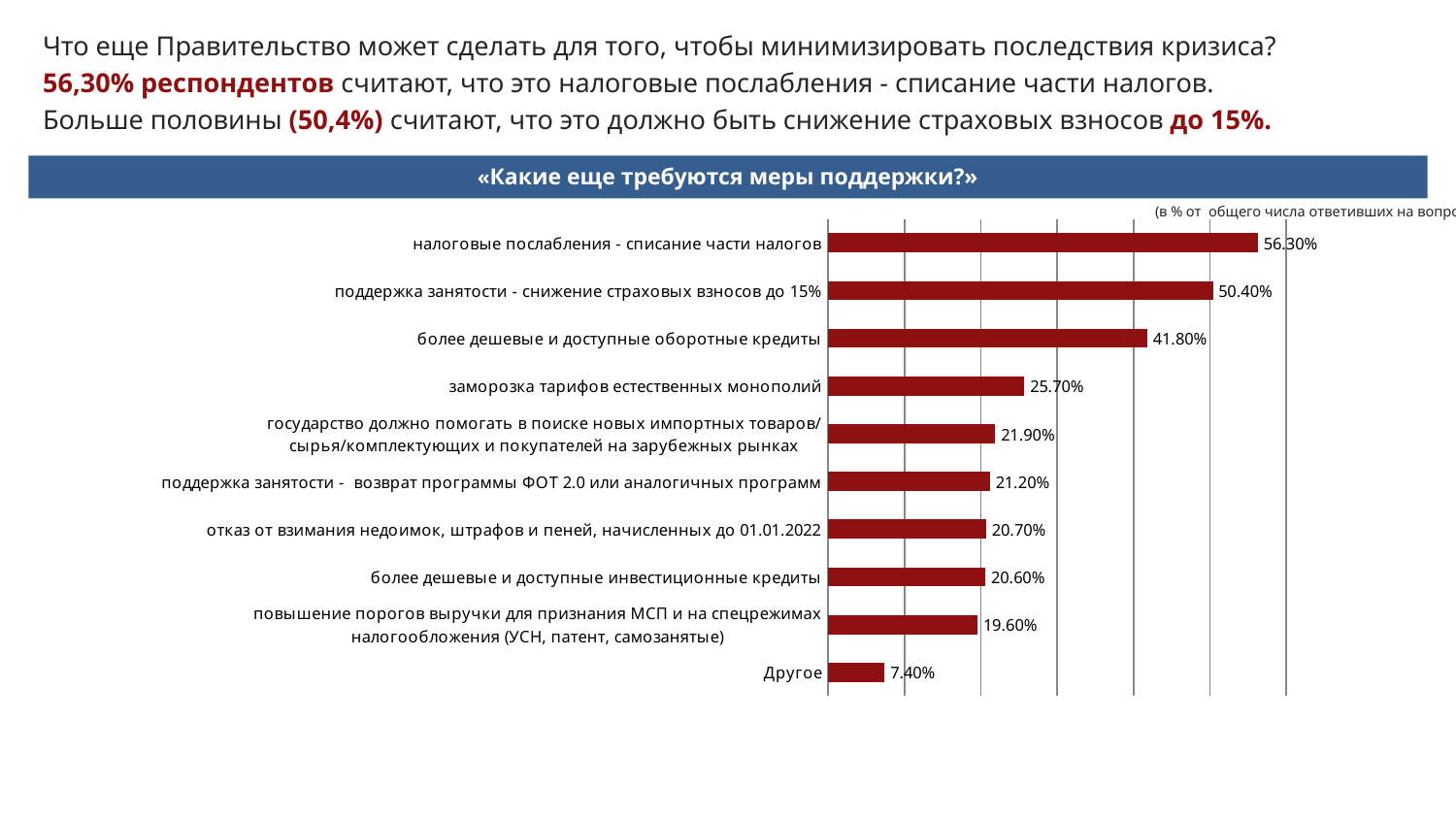
What is the value for «более дешевые и доступные оборотные кредиты»? 41.80% How many categories are shown in the chart? 10 What is the difference between «налоговые послабления - списание части налогов» and «поддержка занятости - снижение страховых взносов до 15%»? 5.90% What is the title of the chart? «Какие еще требуются меры поддержки?» Which category has the lowest value? Другое What is the value for «Другое»? 7.40% What is the value for «заморозка тарифов естественных монополий»? 25.70% What is the value for «налоговые послабления - списание части налогов»? 56.30% Which is larger: «более дешевые и доступные оборотные кредиты» or «заморозка тарифов естественных монополий»? более дешевые и доступные оборотные кредиты What is the value for «более дешевые и доступные инвестиционные кредиты»? 20.60% What kind of chart is shown on the slide? bar chart Which category has the highest value? налоговые послабления - списание части налогов